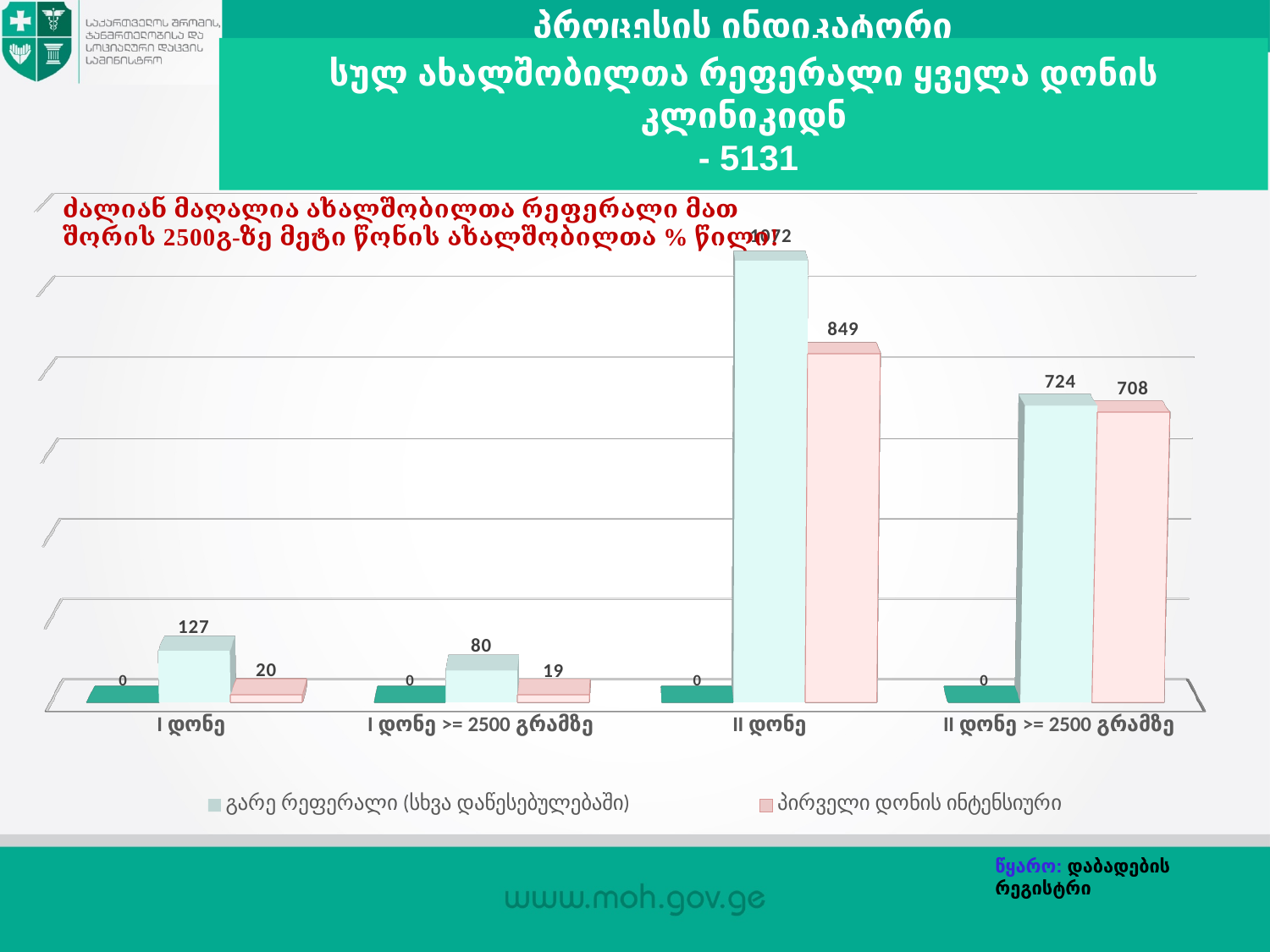
How many categories are shown on the x axis of the chart? 4 What is the difference between გარე რეფერალი and პირველი დონის ინტენსიური for I დონე? 107 What kind of chart is shown on the slide? Bar chart What is the difference between გარე რეფერალი and პირველი დონის ინტენსიური for II დონე >= 2500 გრამზე? 16 What is the value of პირველი დონის ინტენსიური for I დონე? 20 What is the value of გარე რეფერალი (სხვა დაწესებულებაში) for I დონე >= 2500 გრამზე? 80 Which category has the highest value for პირველი დონის ინტენსიური? II დონე What is the value of გარე რეფერალი (სხვა დაწესებულებაში) for I დონე? 127 What is the value of პირველი დონის ინტენსიური for II დონე >= 2500 გრამზე? 708 What is the value of პირველი დონის ინტენსიური for II დონე? 849 For II დონე, which is larger: გარე რეფერალი (სხვა დაწესებულებაში) or პირველი დონის ინტენსიური? გარე რეფერალი (სხვა დაწესებულებაში) What is the value of გარე რეფერალი (სხვა დაწესებულებაში) for II დონე >= 2500 გრამზე? 724